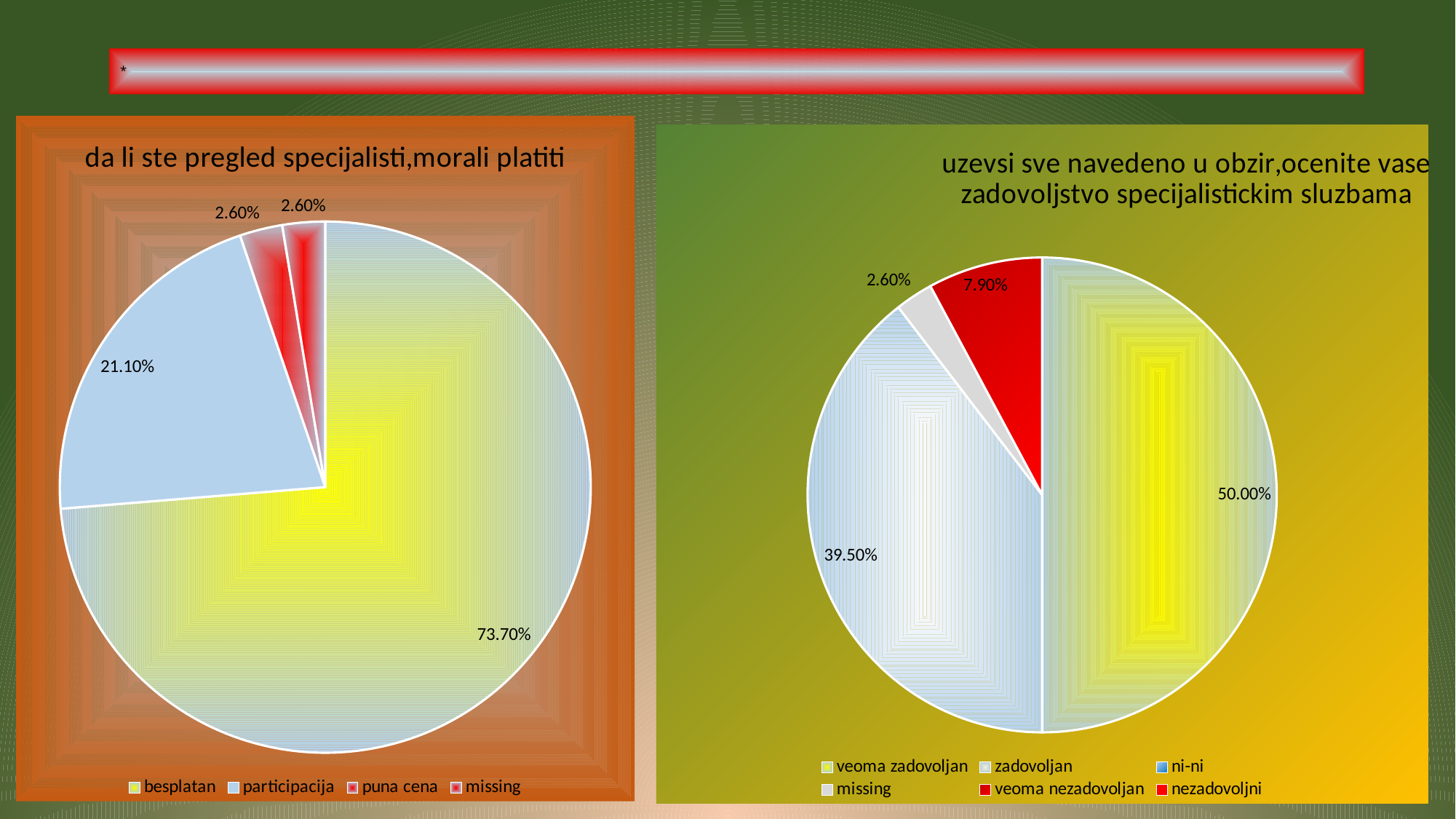
What kind of chart is the left chart 'da li ste pregled specijalisti,morali platiti'? pie chart In the left pie chart 'da li ste pregled specijalisti,morali platiti', what share is labelled for besplatan? 73.70% How many entries does the legend of the left pie chart 'da li ste pregled specijalisti,morali platiti' list? 4 In the right pie chart 'uzevsi sve navedeno u obzir,ocenite vase zadovoljstvo specijalistickim sluzbama', what share is labelled for veoma zadovoljan? 50.00% In the left pie chart 'da li ste pregled specijalisti,morali platiti', what share is labelled for puna cena? 2.60% In the left pie chart 'da li ste pregled specijalisti,morali platiti', what is the difference between the besplatan and participacija shares? 52.60% How many entries does the legend of the right pie chart 'uzevsi sve navedeno u obzir,ocenite vase zadovoljstvo specijalistickim sluzbama' list? 6 In the right pie chart 'uzevsi sve navedeno u obzir,ocenite vase zadovoljstvo specijalistickim sluzbama', what is the difference between the 50.00% slice and the 39.50% slice? 10.50% In the right pie chart 'uzevsi sve navedeno u obzir,ocenite vase zadovoljstvo specijalistickim sluzbama', what is the largest labelled share? 50.00% In the left pie chart 'da li ste pregled specijalisti,morali platiti', which category has the largest slice? besplatan